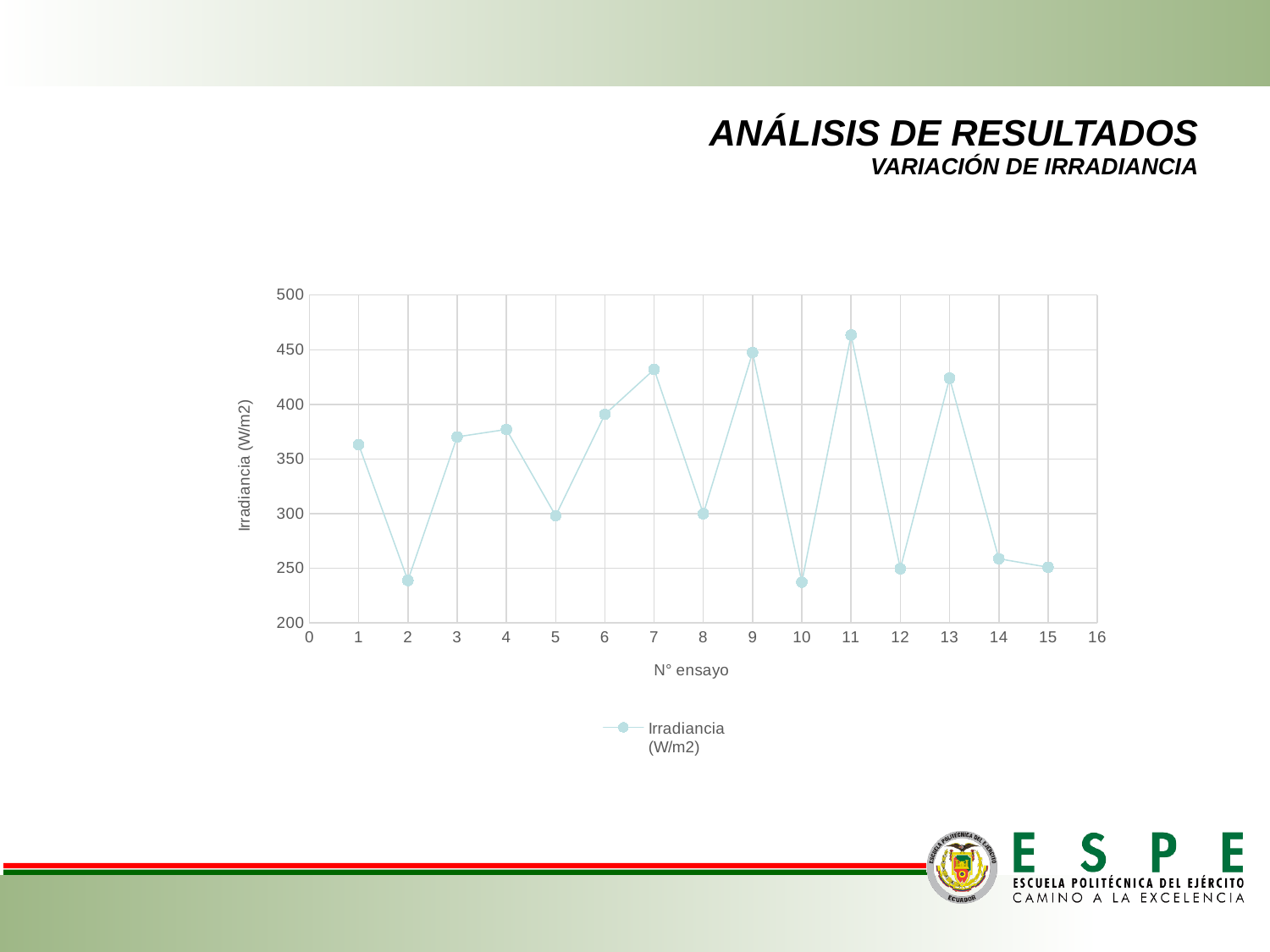
Is the irradiance value for ensayo 2 greater or less than 250? less What is the label of the horizontal axis? N° ensayo Is the irradiance value for ensayo 7 greater or less than 400? greater Is the irradiance value for ensayo 1 greater or less than 350? greater How many data points (ensayos) are plotted on the chart? 15 What kind of chart is shown on the slide? Line chart Does the irradiance rise or fall from ensayo 9 to ensayo 10? Fall At which N° ensayo is the irradiance highest? 11 Which has the higher irradiance, ensayo 8 or ensayo 9? Ensayo 9 How many series does the legend list? 1 What is the label of the vertical axis? Irradiancia (W/m2)